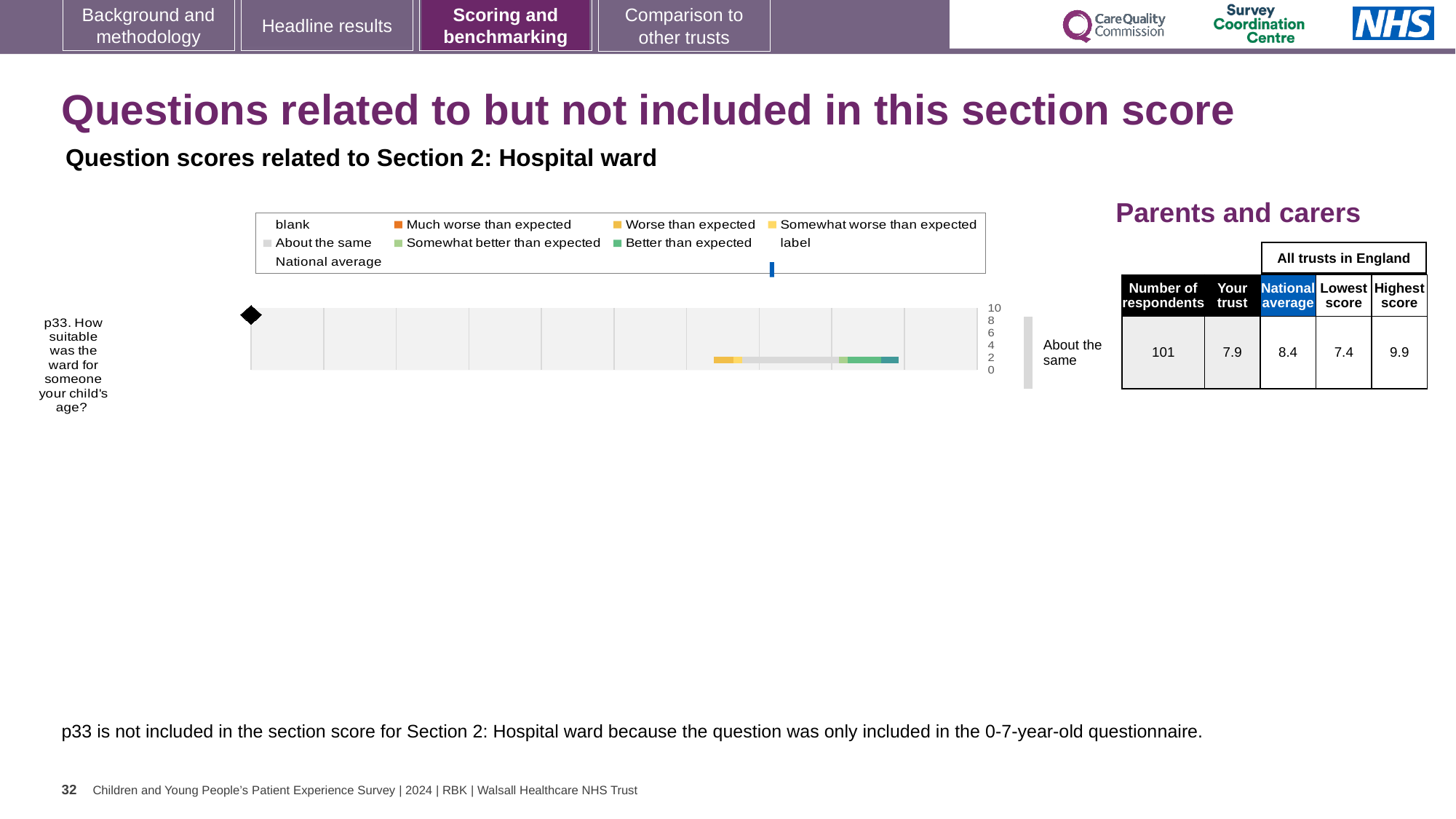
In the table beside the chart, how many respondents are recorded for p33? 101 Which survey question is plotted in the chart? p33. How suitable was the ward for someone your child's age? In the table beside the chart, what is the national average score for p33? 8.4 For p33, which is larger: the 'Your trust' score or the national average? National average How many survey questions are plotted in the chart? 1 In the table beside the chart, what is the 'Your trust' score for p33? 7.9 In the table beside the chart, what is the highest score among all trusts in England for p33? 9.9 What is the highest value shown on the chart's axis? 10 What kind of chart is shown for p33 on the slide? bar chart In the table beside the chart, what is the lowest score among all trusts in England for p33? 7.4 For p33, what is the difference between the national average (8.4) and the 'Your trust' score (7.9)? 0.5 What benchmark category is shown for p33 next to the chart? About the same